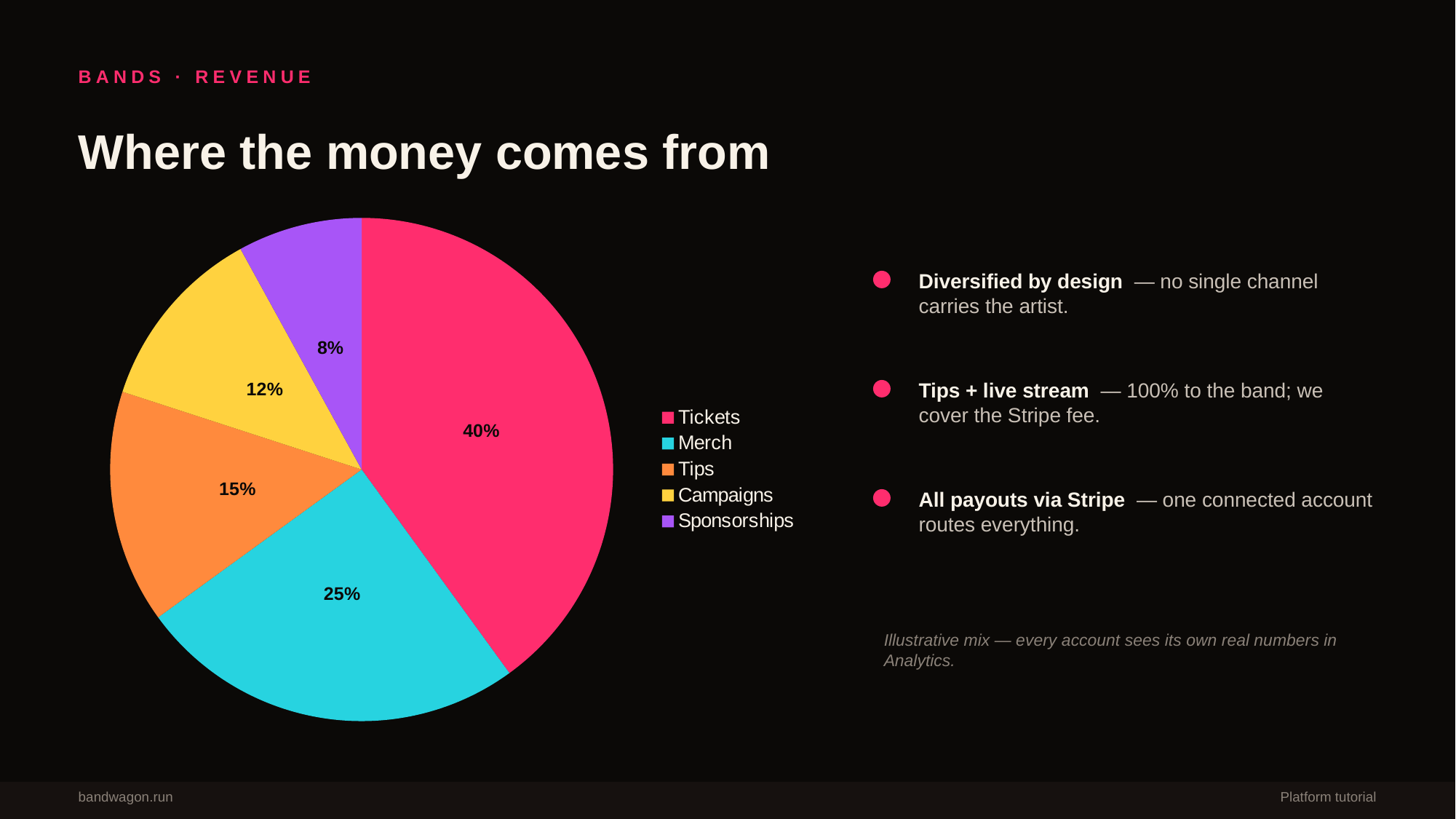
What share of revenue comes from Merch? 25% Which revenue source has the largest slice of the pie? Tickets What share of revenue comes from Tickets? 40% How many revenue categories does the pie chart show? 5 What share of revenue comes from Campaigns? 12% What kind of chart is shown on the slide? pie chart What share of revenue comes from Tips? 15% Which revenue source has the smallest slice of the pie? Sponsorships Which is larger, the share for Tips or the share for Campaigns? Tips How many percentage points larger is the Tickets share than the Merch share? 15 What share of revenue comes from Sponsorships? 8% What colour is the Merch slice in the pie chart? cyan